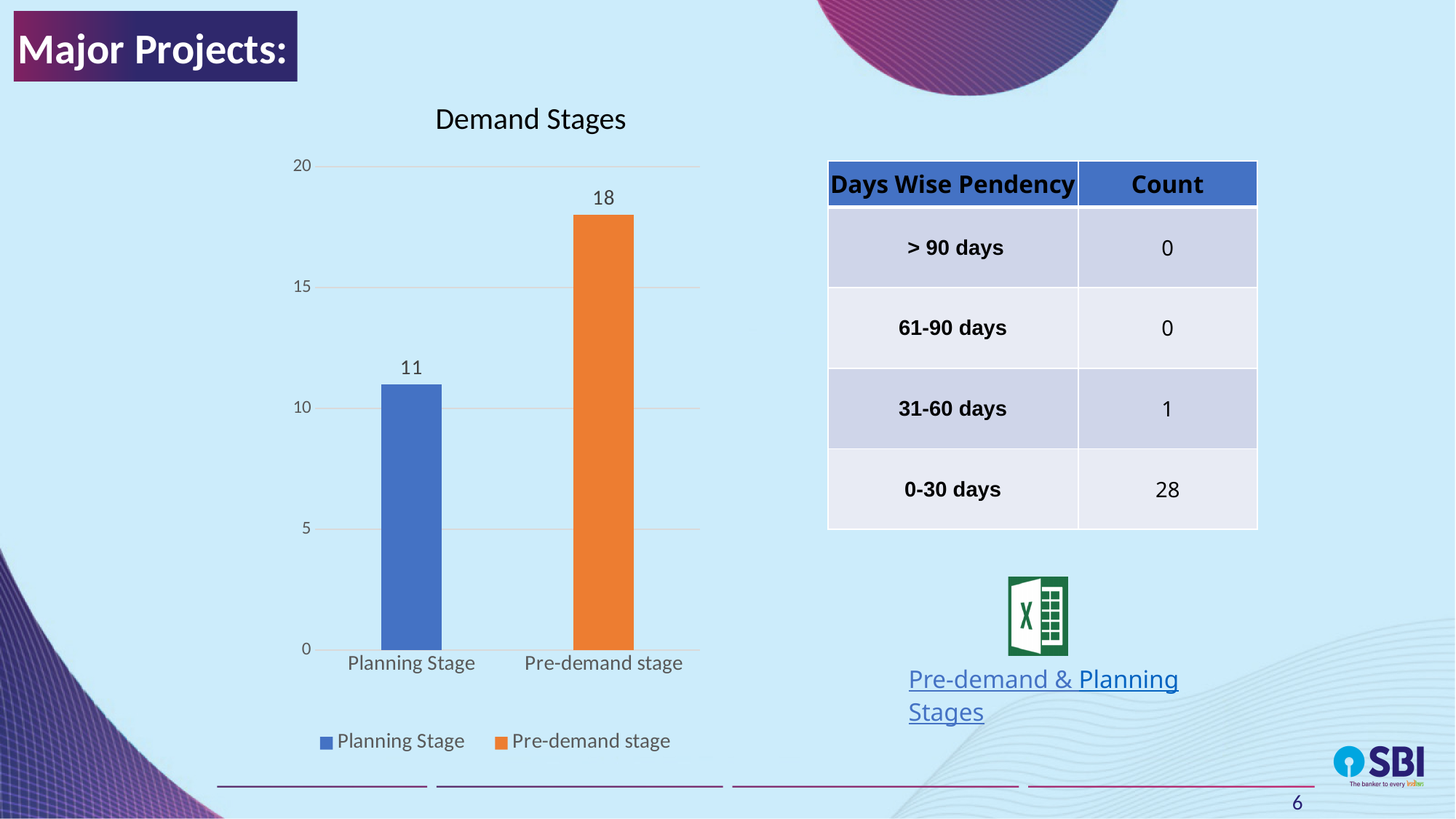
In the Demand Stages chart, which is larger: Planning Stage or Pre-demand stage? Pre-demand stage What kind of chart is the Demand Stages chart? Bar chart What colour is the Pre-demand stage bar in the Demand Stages chart? Orange Is the value for Pre-demand stage in the Demand Stages chart greater or less than 15? greater What is the difference between the Pre-demand stage and Planning Stage values in the Demand Stages chart? 7 How many categories are shown in the Demand Stages chart? 2 Which category has the lowest value in the Demand Stages chart? Planning Stage How many entries does the legend of the Demand Stages chart list? 2 What is the value for Planning Stage in the Demand Stages chart? 11 Which category has the highest value in the Demand Stages chart? Pre-demand stage Is the value for Planning Stage in the Demand Stages chart greater or less than 15? less What is the value for Pre-demand stage in the Demand Stages chart? 18